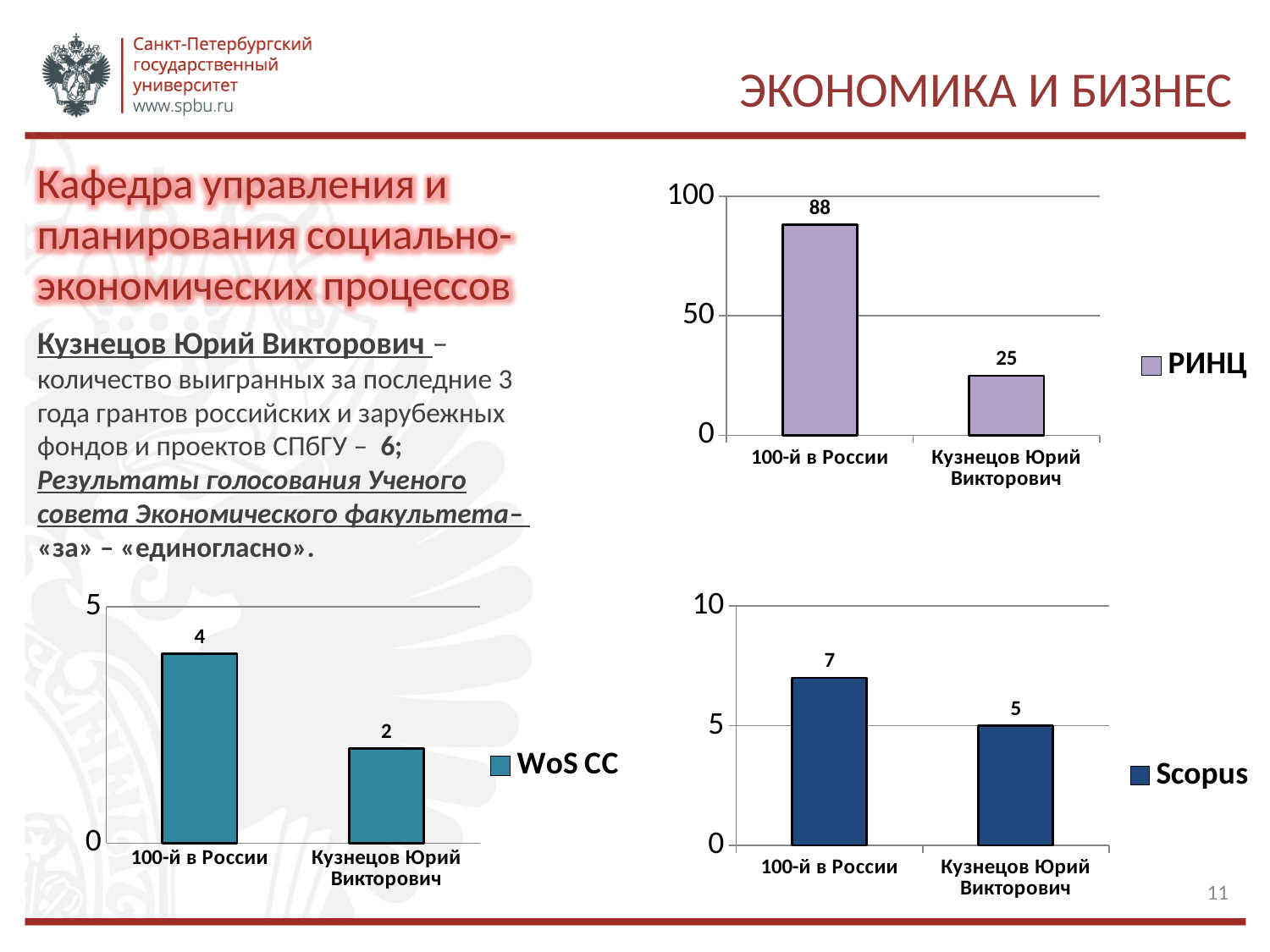
In the РИНЦ chart, is the value for Кузнецов Юрий Викторович greater or less than 50? less In the РИНЦ chart, what is the difference between the values for 100-й в России and Кузнецов Юрий Викторович? 63 In the РИНЦ chart, what is the value for 100-й в России? 88 In the Scopus chart, what is the value for 100-й в России? 7 In the Scopus chart, which category has the highest value? 100-й в России In the WoS CC chart, what is the value for 100-й в России? 4 In the РИНЦ chart, what is the value for Кузнецов Юрий Викторович? 25 What kind of chart is the Scopus chart? bar chart In the Scopus chart, what is the difference between the values for 100-й в России and Кузнецов Юрий Викторович? 2 In the Scopus chart, what is the value for Кузнецов Юрий Викторович? 5 In the WoS CC chart, what is the value for Кузнецов Юрий Викторович? 2 In the WoS CC chart, which category has the lowest value? Кузнецов Юрий Викторович